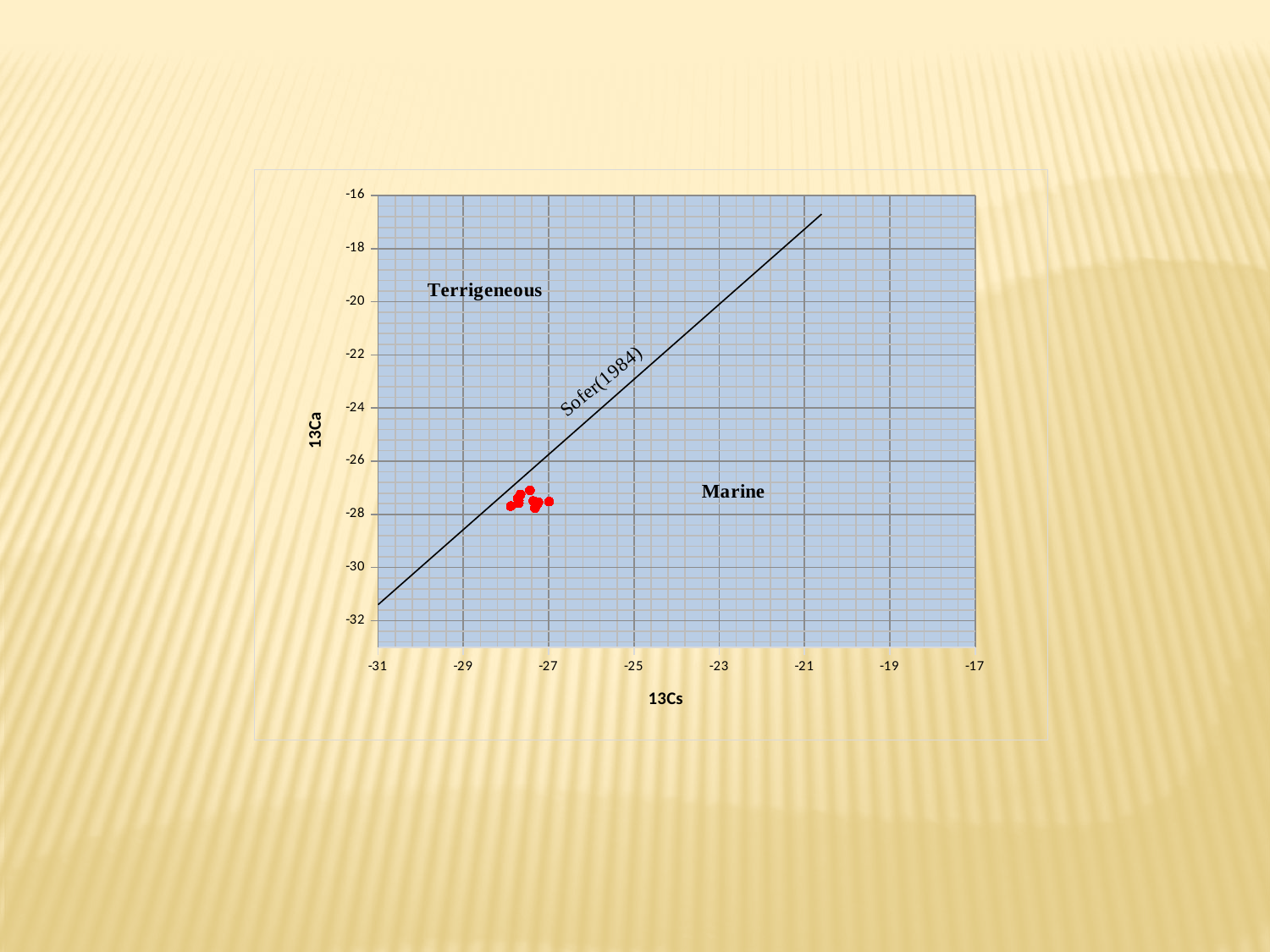
Are the 13Cs values of the red data points greater or less than -29? greater What is the lowest value shown on the x axis? -31 What is the label of the x axis? 13Cs Which region label appears above the Sofer(1984) line? Terrigeneous Are the 13Ca values of the red data points greater or less than -26? less What is the highest value shown on the y axis? -16 Are the 13Ca values of the red data points greater or less than -30? greater Does the Sofer(1984) line rise or fall as the x-axis value increases from -31 to -17? rise Which labelled region of the chart do the red data points fall in, Terrigeneous or Marine? Marine What is the label of the y axis? 13Ca What is the label on the diagonal reference line in the chart? Sofer(1984) What kind of chart is shown on the slide? scatter plot